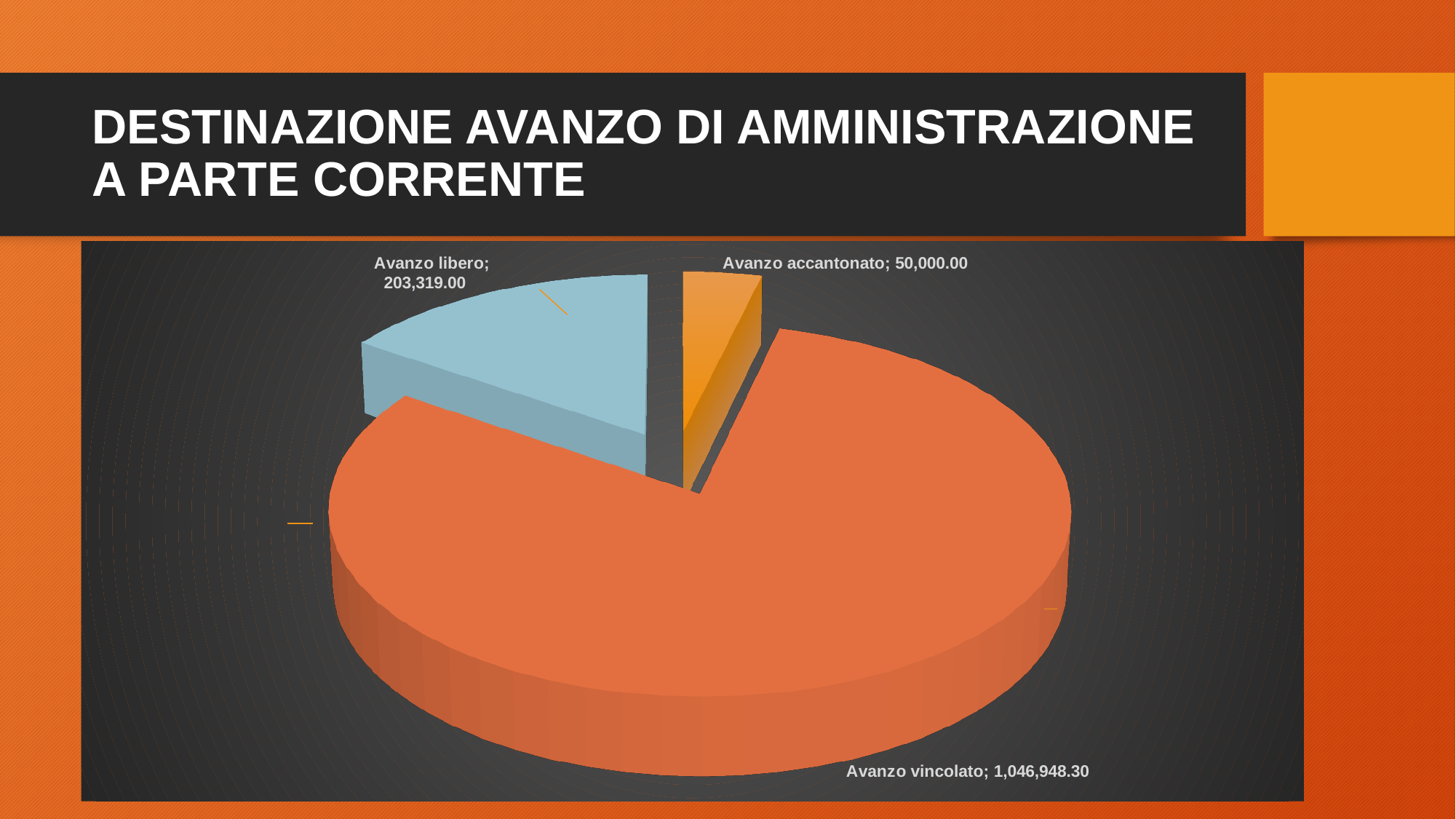
Which category has the smallest slice of the pie? Avanzo accantonato What is the difference between the values for Avanzo libero and Avanzo accantonato? 153,319.00 What is the value for Avanzo vincolato? 1,046,948.30 How many slices does the pie chart have? 3 Which is larger, the value for Avanzo libero or the value for Avanzo accantonato? Avanzo libero What is the difference between the values for Avanzo vincolato and Avanzo libero? 843,629.30 What is the value for Avanzo accantonato? 50,000.00 What type of chart is shown on the slide? Pie chart What is the total of all three slices in the pie chart? 1,300,267.30 What is the title of the slide containing the pie chart? DESTINAZIONE AVANZO DI AMMINISTRAZIONE A PARTE CORRENTE Which category has the largest slice of the pie? Avanzo vincolato What is the value for Avanzo libero? 203,319.00